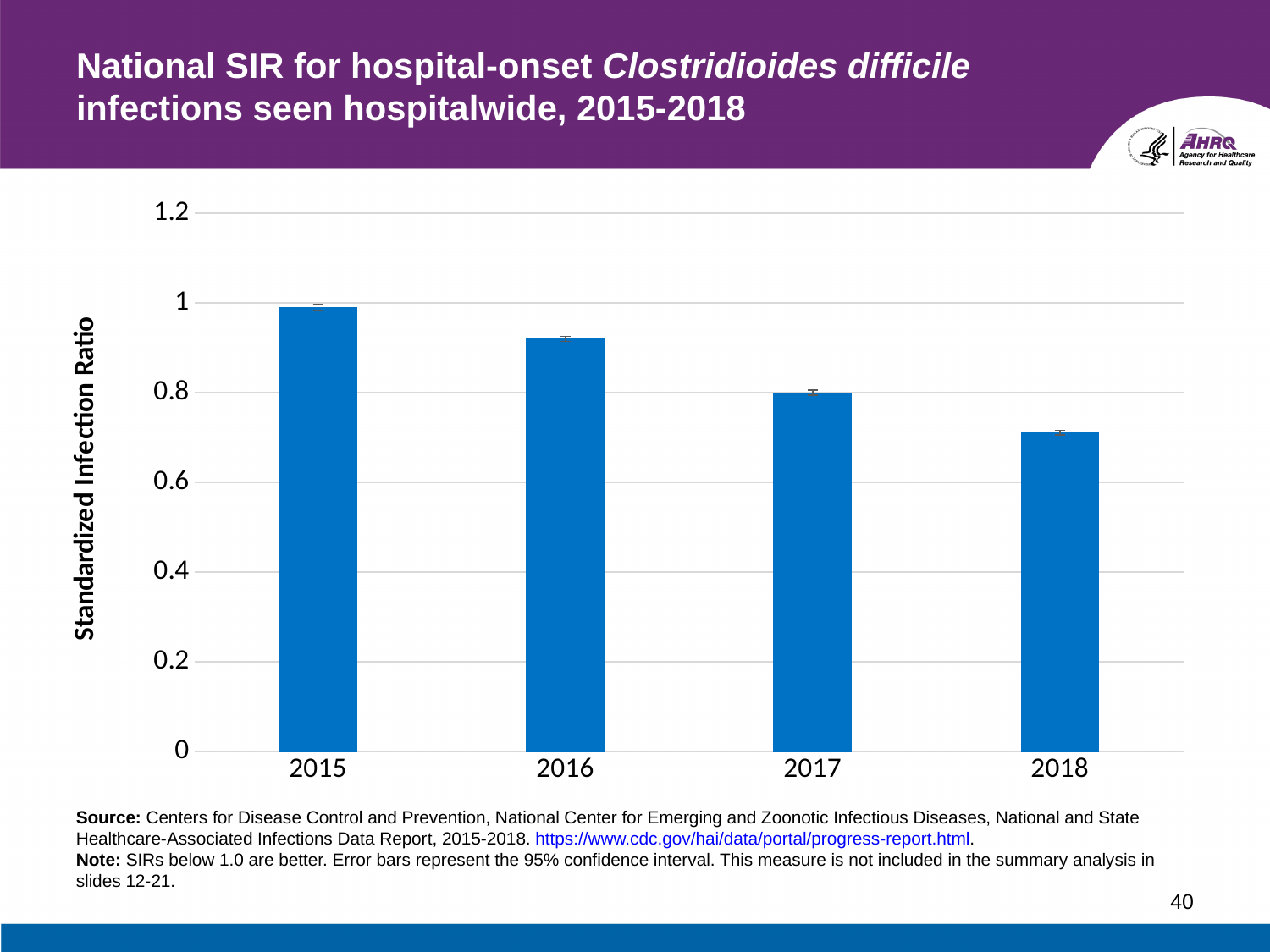
Is the Standardized Infection Ratio for 2018 greater or less than 0.8? less Is the Standardized Infection Ratio for 2017 greater or less than 1? less Is the Standardized Infection Ratio for 2016 greater or less than 0.8? greater What is the highest value shown on the vertical axis of the chart? 1.2 Which year has a larger Standardized Infection Ratio, 2016 or 2018? 2016 Which year has the lowest Standardized Infection Ratio? 2018 What kind of chart is shown on the slide? Bar chart What is the label on the vertical axis of the chart? Standardized Infection Ratio Do the Standardized Infection Ratio values rise or fall from 2015 to 2018? Fall Which year has the highest Standardized Infection Ratio? 2015 How many years are plotted on the chart? 4